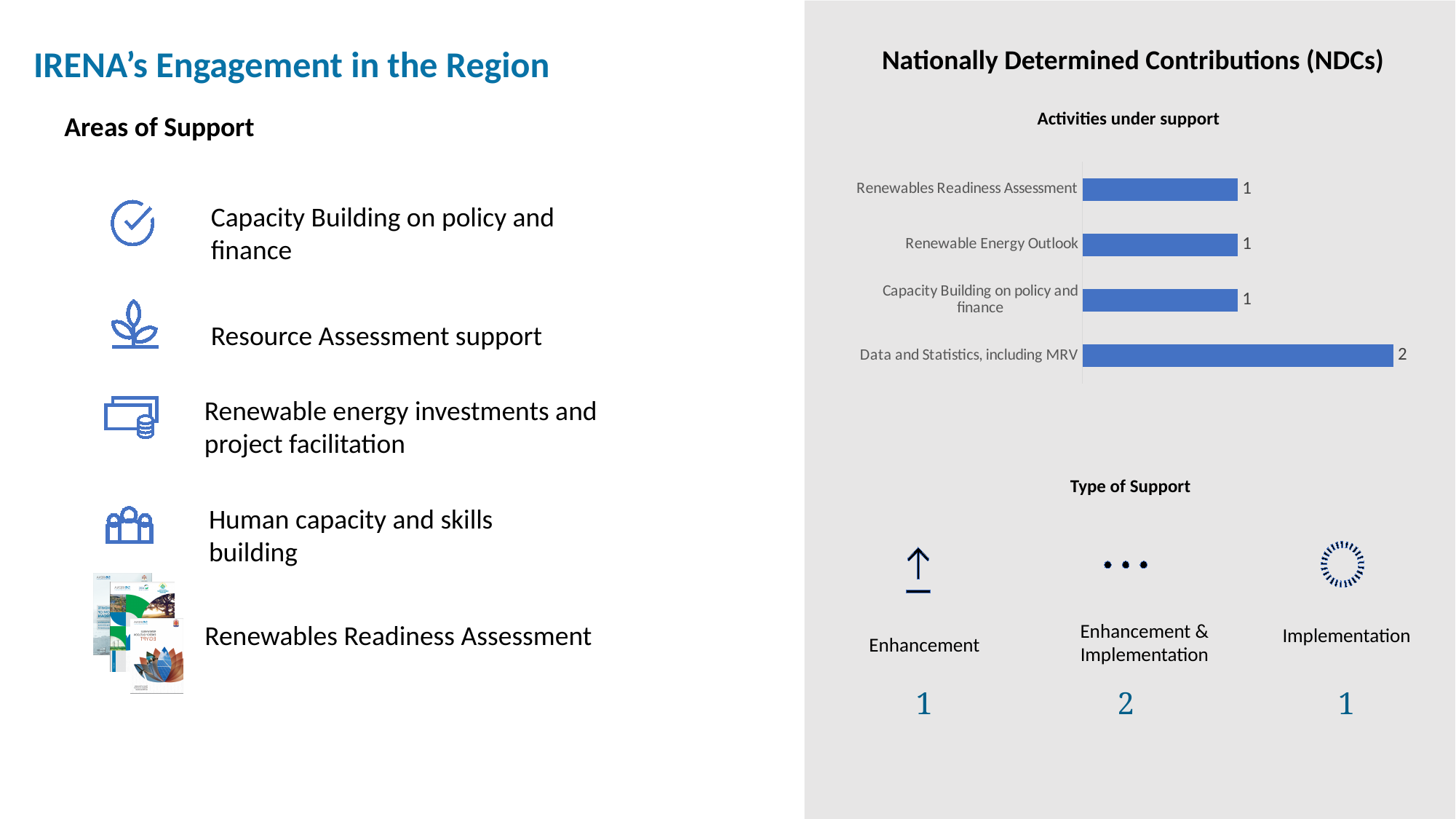
In the 'Activities under support' chart, what is the value for Data and Statistics, including MRV? 2 In the 'Activities under support' chart, what is the value for Capacity Building on policy and finance? 1 What kind of chart is the 'Activities under support' chart? Bar chart In the 'Activities under support' chart, what is the value for Renewable Energy Outlook? 1 In the 'Activities under support' chart, which category has the highest value? Data and Statistics, including MRV In the 'Activities under support' chart, which is larger: Data and Statistics, including MRV or Capacity Building on policy and finance? Data and Statistics, including MRV What colour are the bars in the 'Activities under support' chart? Blue In the 'Activities under support' chart, what is the value for Renewables Readiness Assessment? 1 How many categories are shown in the 'Activities under support' chart? 4 In the 'Activities under support' chart, what is the difference between Data and Statistics, including MRV and Renewable Energy Outlook? 1 What is the title of the bar chart on the slide? Activities under support